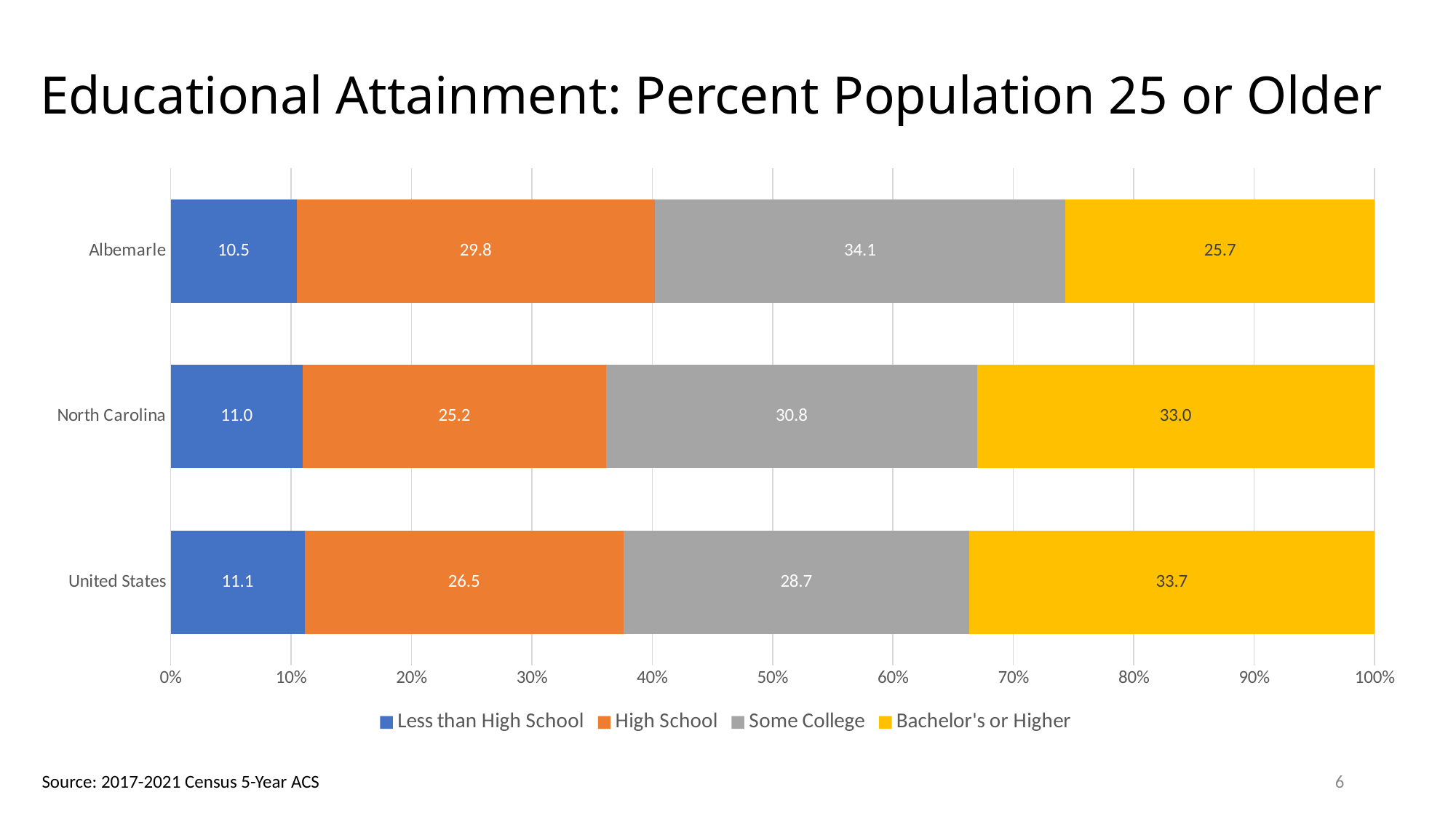
How many categories are shown on the y axis? 3 What is the High School value for the United States? 26.5 What is the Some College value for Albemarle? 34.1 What is the total of the stacked bar for North Carolina? 100.0 Which colour represents the Some College series? Gray Which is larger, the High School value for Albemarle or for North Carolina? Albemarle What kind of chart is shown on the slide? Stacked bar chart How many series does the legend list? 4 Which category has the highest Bachelor's or Higher value? United States Which category has the lowest Less than High School value? Albemarle What is the difference between the Bachelor's or Higher values for the United States and Albemarle? 8.0 What is the Bachelor's or Higher value for North Carolina? 33.0